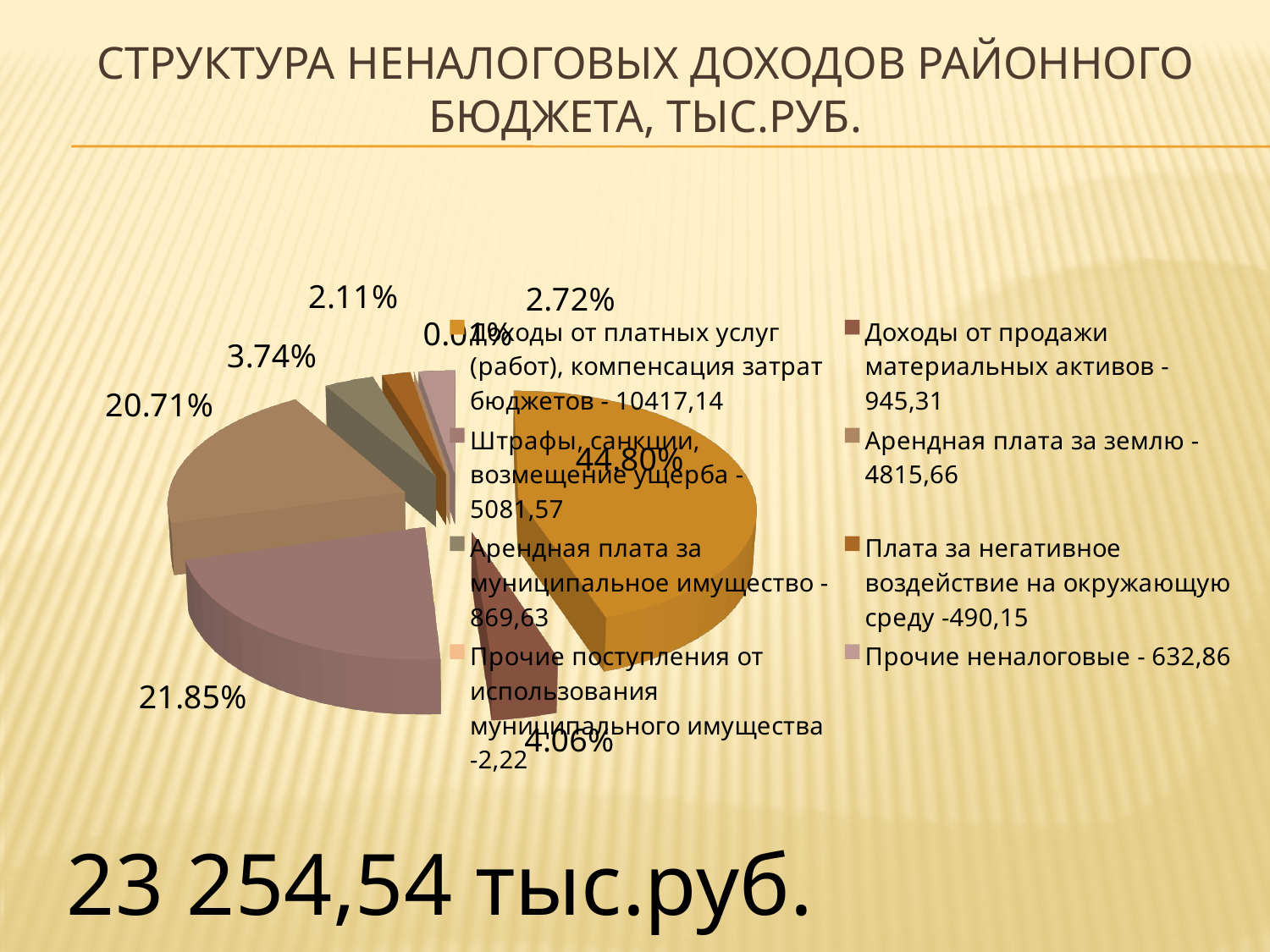
What share of the pie does Арендная плата за землю have? 20.71% What share of the pie does the largest slice (Доходы от платных услуг) have? 44.80% What value is given in the legend for Арендная плата за землю? 4815,66 Which category has the smallest share of the pie? Прочие поступления от использования муниципального имущества What kind of chart is shown on the slide? pie chart How many categories does the legend of the pie chart list? 8 What total amount of non-tax revenue is stated on the slide? 23 254,54 тыс.руб. Which is larger: Доходы от продажи материальных активов or Арендная плата за муниципальное имущество? Доходы от продажи материальных активов What share of the pie does Штрафы, санкции, возмещение ущерба have? 21.85% Which category has the largest share of the pie? Доходы от платных услуг (работ), компенсация затрат бюджетов What value is given in the legend for Плата за негативное воздействие на окружающую среду? 490,15 What is the difference between the values for Доходы от платных услуг (10417,14) and Штрафы, санкции, возмещение ущерба (5081,57)? 5335,57